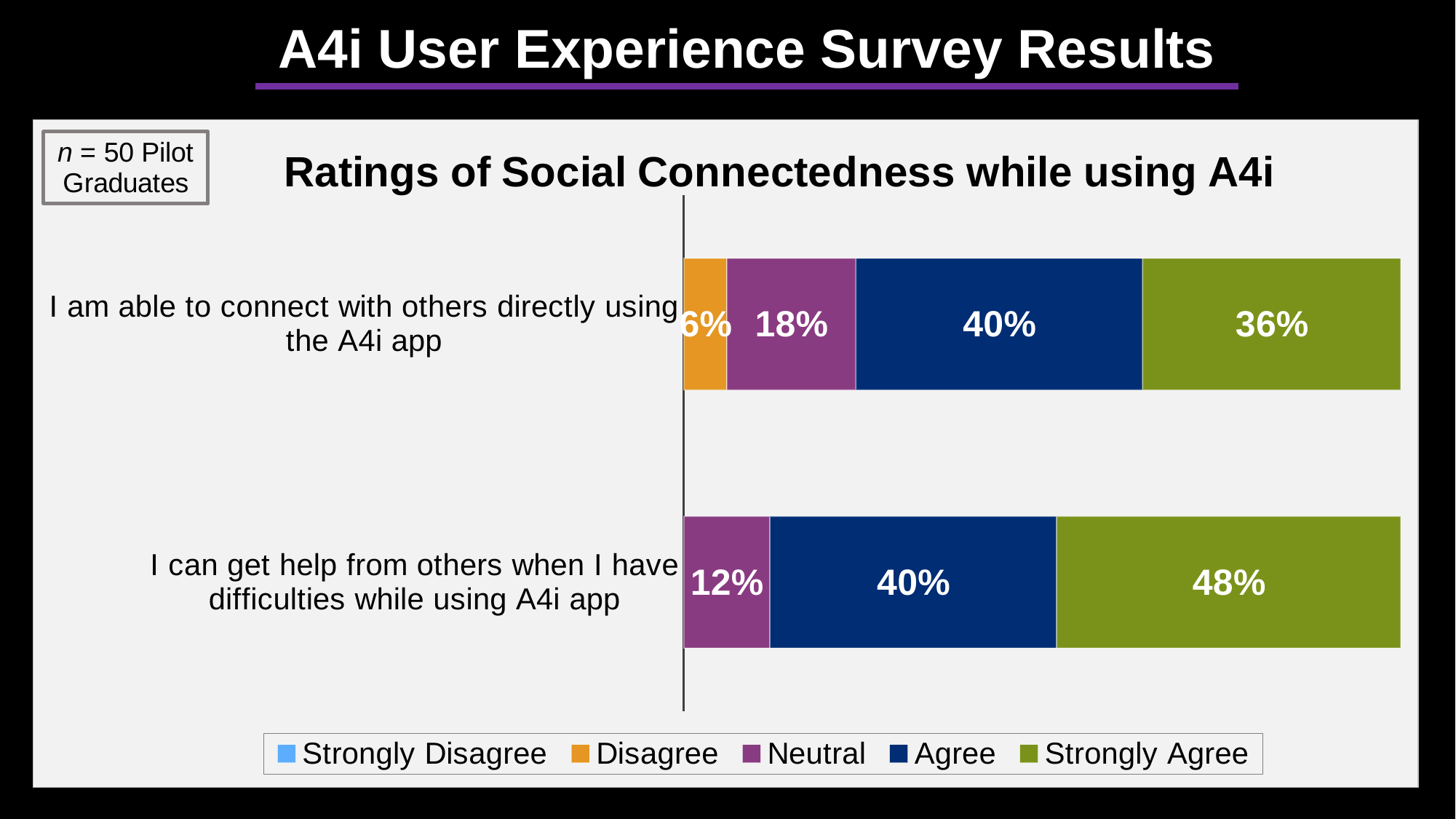
What percentage of respondents selected Strongly Agree for "I can get help from others when I have difficulties while using A4i app"? 48% What percentage of respondents selected Disagree for "I am able to connect with others directly using the A4i app"? 6% What percentage of respondents selected Neutral for "I am able to connect with others directly using the A4i app"? 18% Which response category has the largest share for "I can get help from others when I have difficulties while using A4i app"? Strongly Agree What kind of chart is shown on the slide? Stacked bar chart Which response category has the largest share for "I am able to connect with others directly using the A4i app"? Agree How many statements (categories) are shown in the chart? 2 Which statement has a higher Neutral percentage? I am able to connect with others directly using the A4i app How many series does the legend list? 5 What percentage of respondents selected Agree for "I can get help from others when I have difficulties while using A4i app"? 40% What is the difference between the Strongly Agree percentages for the two statements? 12% What is the title of the chart? Ratings of Social Connectedness while using A4i